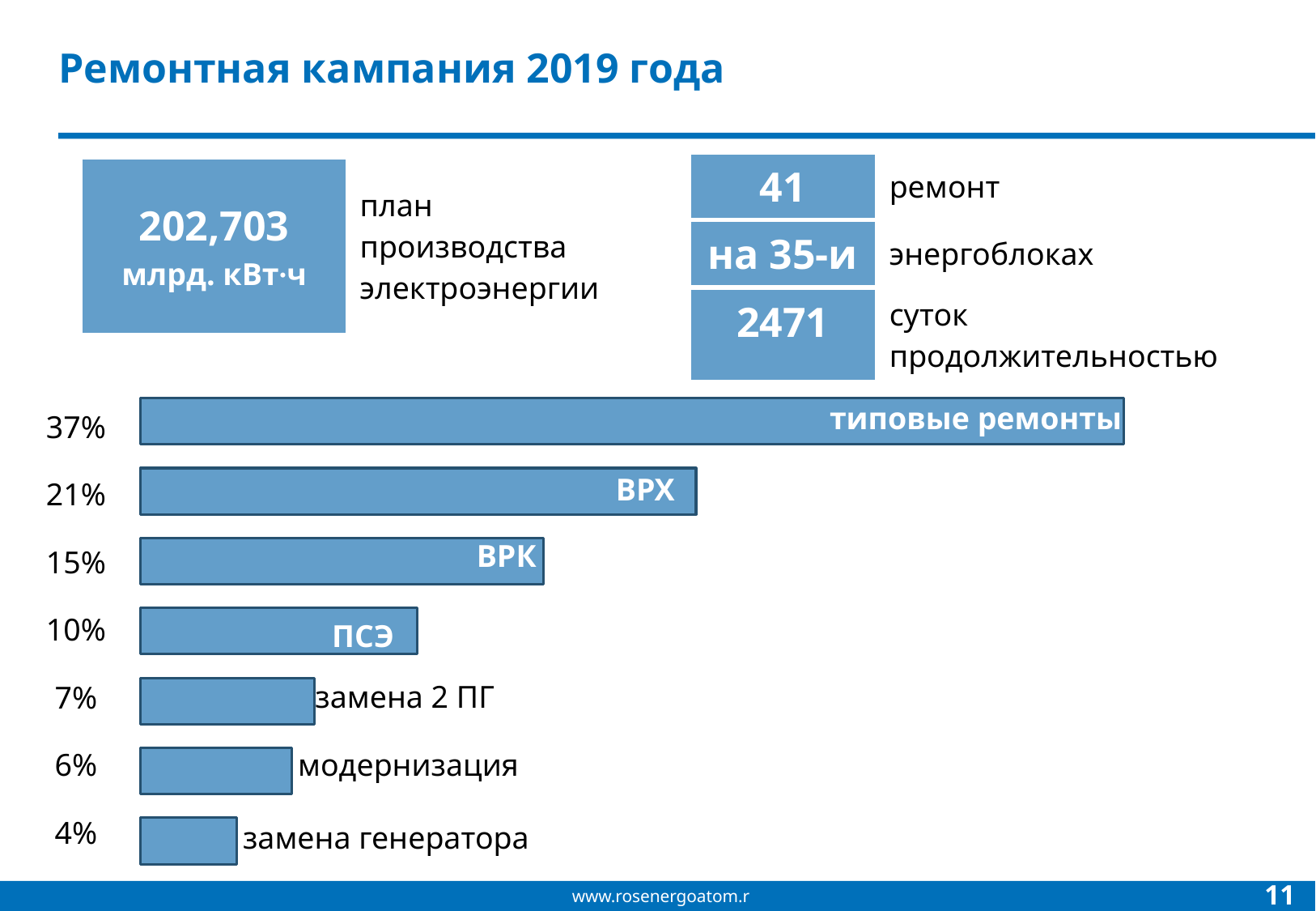
Which is larger, the value for модернизация or the value for замена 2 ПГ? замена 2 ПГ What is the title of the slide containing the chart? Ремонтная кампания 2019 года What is the difference between the values for типовые ремонты and ПСЭ? 27% How many categories does the bar chart show? 7 Which category has the lowest value? замена генератора What kind of chart is shown on the slide? bar chart What is the difference between the values for ВРХ and ВРК? 6% What is the value for ВРХ? 21% What is the value for типовые ремонты? 37% Which category has the highest value? типовые ремонты What is the value for замена генератора? 4% What is the value for ПСЭ? 10%